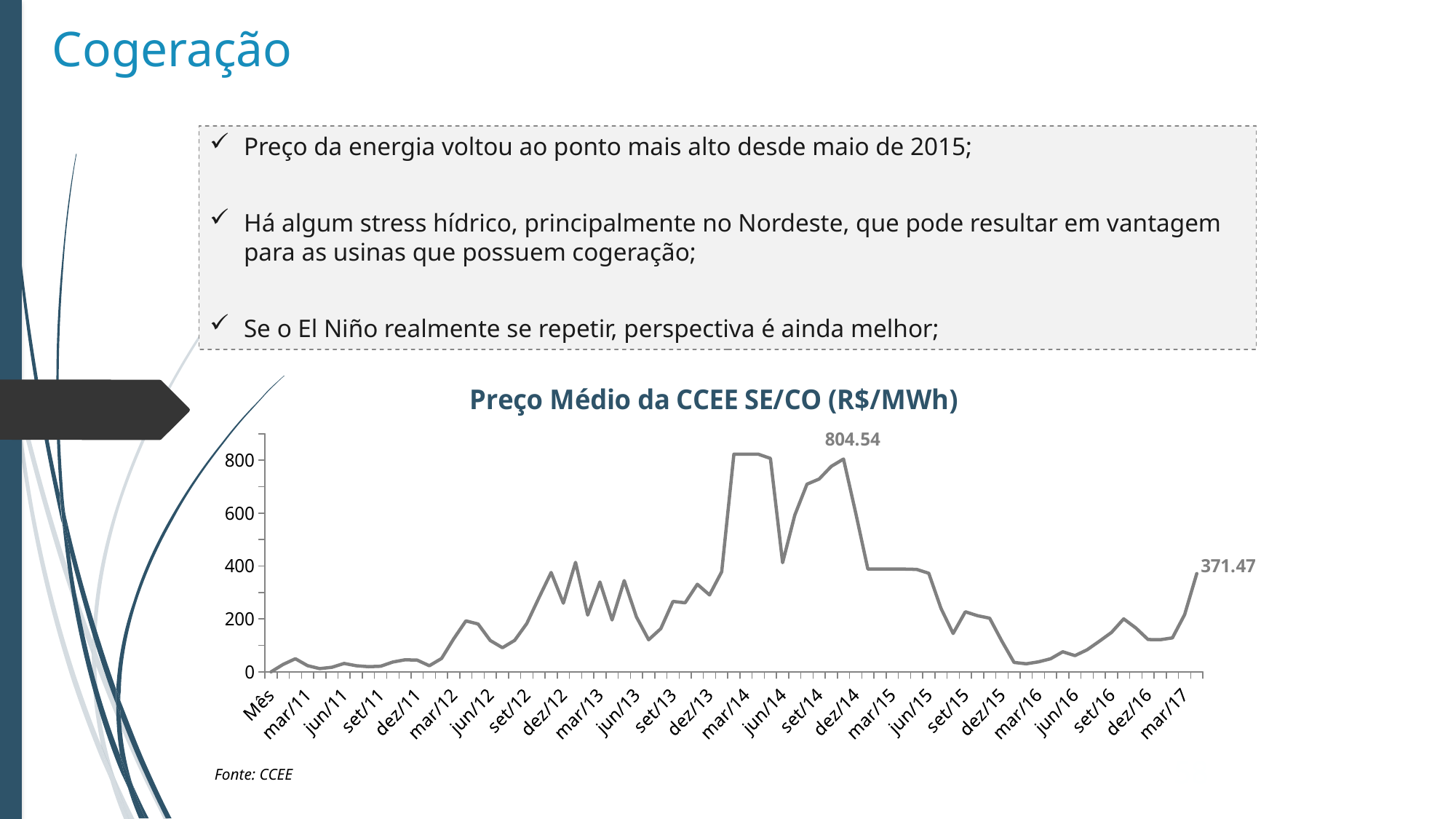
Do the values rise or fall between dez/16 and mar/17? rise Is the value for jun/15 greater or less than 200? greater Is the value for mar/14 greater or less than 600? greater Do the values rise or fall between dez/14 and mar/15? fall What is the larger of the two data labels printed on the chart? 804.54 Is the value for mar/16 greater or less than 200? less What kind of chart is shown on the slide? line chart What source is cited below the chart? CCEE What is the title of the chart? Preço Médio da CCEE SE/CO (R$/MWh) What is the value of the last data point (mar/17) on the chart? 371.47 Which is larger, the value for mar/14 or the value for mar/17? mar/14